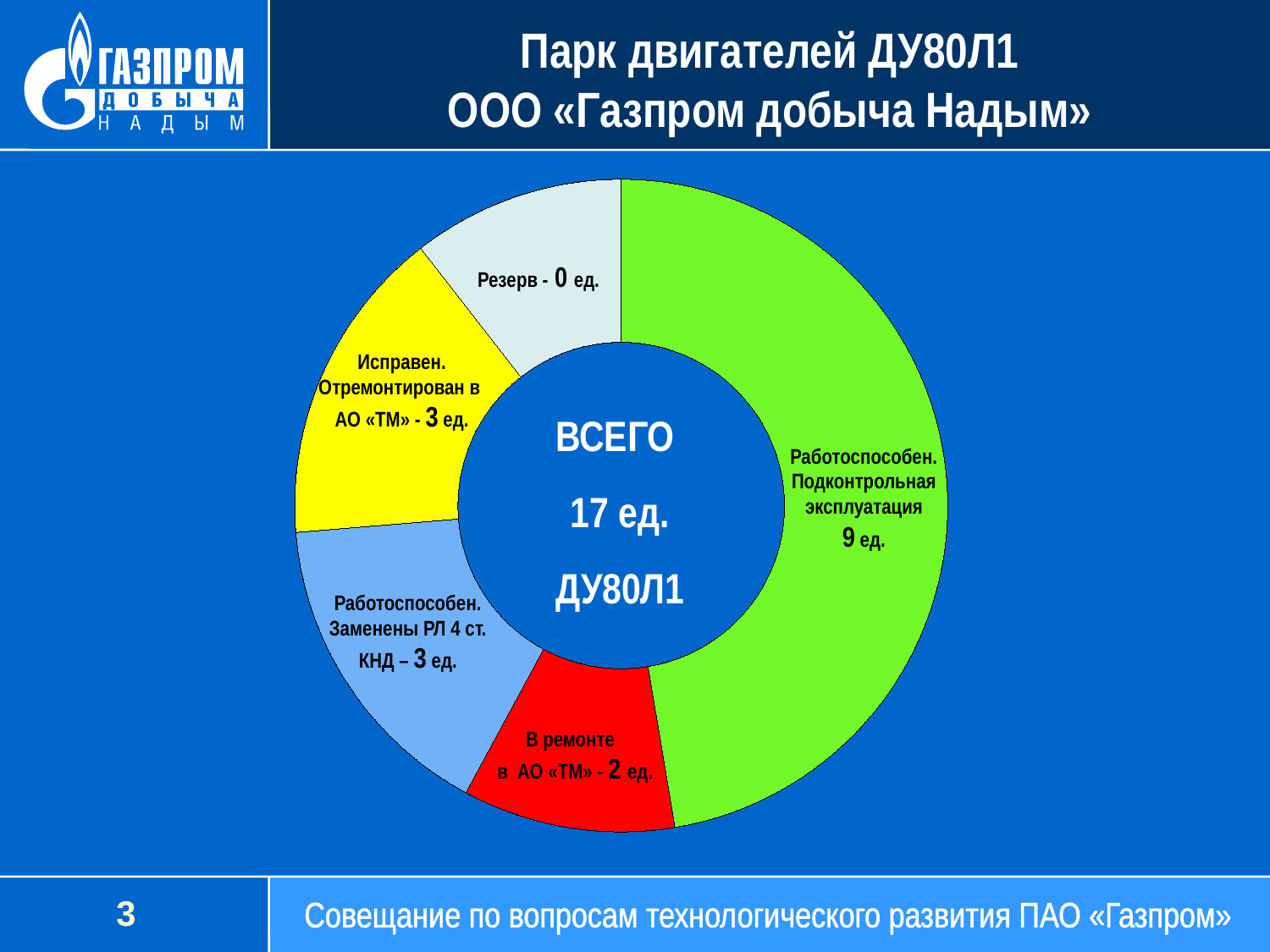
What is the total number of ДУ80Л1 engines shown in the centre of the chart? 17 ед. How many engines are in the category «Работоспособен. Подконтрольная эксплуатация»? 9 ед. How many engines are in the category «Работоспособен. Заменены РЛ 4 ст. КНД»? 3 ед. Which category has the smallest number of engines? Резерв How many engines are in the category «Исправен. Отремонтирован в АО «ТМ»»? 3 ед. What type of chart is shown on the slide? Doughnut (pie) chart How many engines are listed as «Резерв»? 0 ед. How many engines are «В ремонте в АО «ТМ»»? 2 ед. Which category has the largest number of engines? Работоспособен. Подконтрольная эксплуатация What colour is the segment for «В ремонте в АО «ТМ»»? Red What is the difference between the number of engines in «Работоспособен. Подконтрольная эксплуатация» and «В ремонте в АО «ТМ»»? 7 ед. How many categories (segments) does the chart have? 5